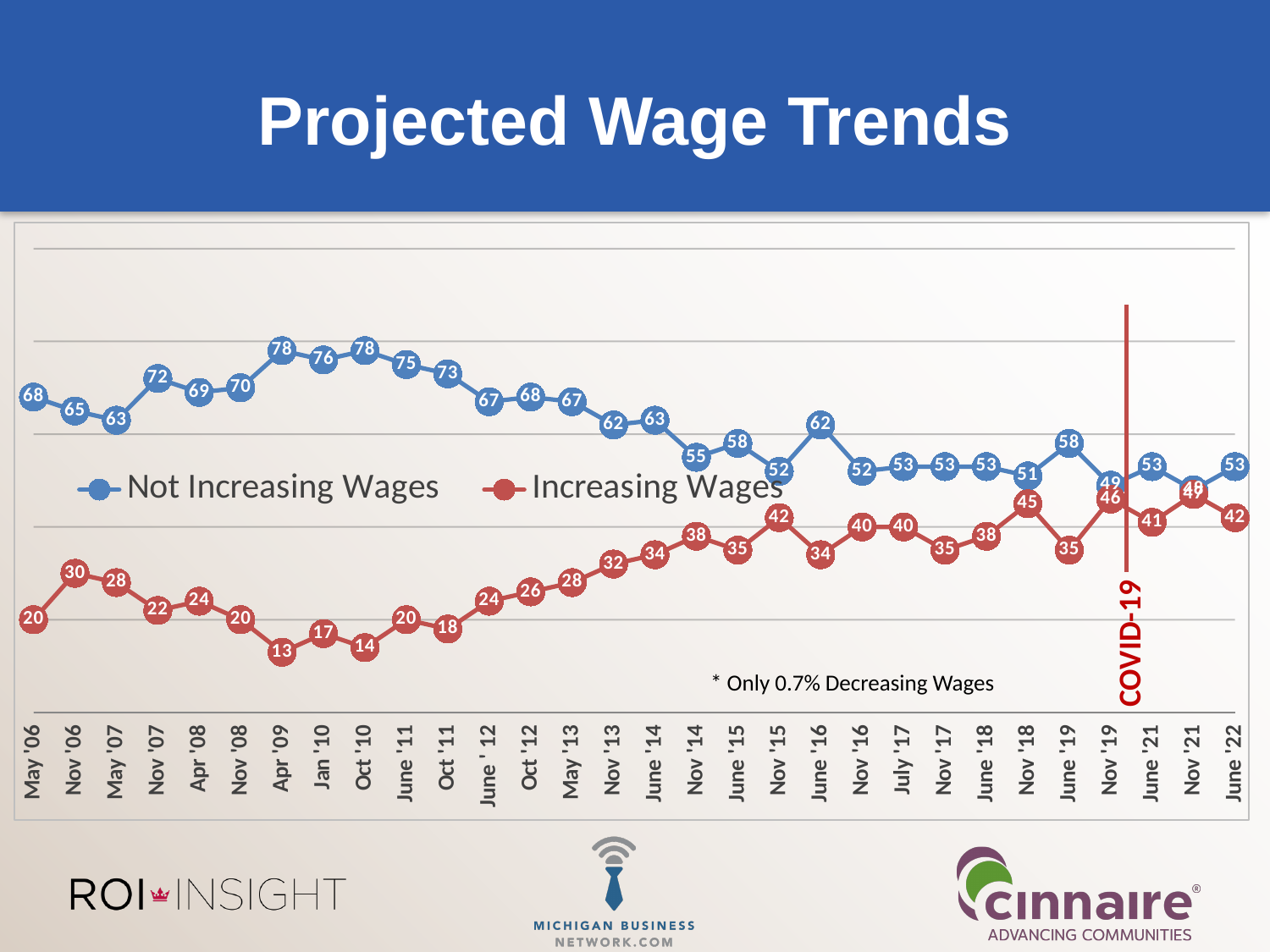
What is the value for Increasing Wages in Nov '15? 42 What are the two series named in the legend? Not Increasing Wages and Increasing Wages What is the value for Increasing Wages in Apr '09? 13 In which period is the Increasing Wages series at its lowest? Apr '09 How many time periods are shown on the x axis? 30 What is the value for Not Increasing Wages in May '06? 68 What is the value for Not Increasing Wages in June '22? 53 What is the difference between Not Increasing Wages and Increasing Wages in May '06? 48 What label is written on the red vertical line near Nov '19? COVID-19 In June '16, which series has the larger value, Not Increasing Wages or Increasing Wages? Not Increasing Wages What kind of chart is shown on the slide? line chart How many series does the legend list? 2